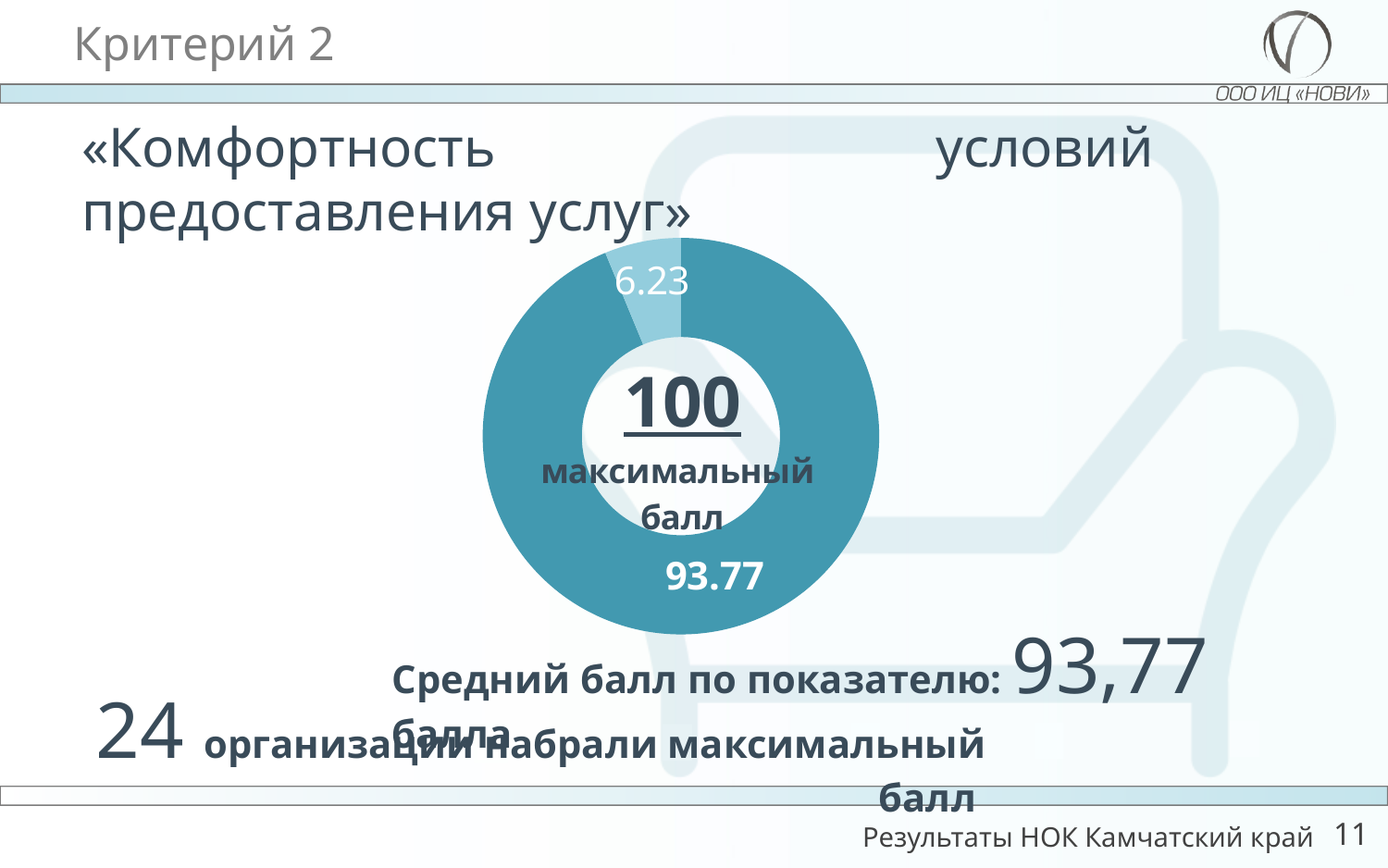
What is the value of the larger slice of the doughnut chart? 93.77 What is the smallest value shown on the doughnut chart? 6.23 What is the largest value shown on the doughnut chart? 93.77 Which slice is larger on the doughnut chart, the one labelled 93.77 or the one labelled 6.23? 93.77 What is the value of the smaller slice of the doughnut chart? 6.23 What text accompanies the number in the centre of the doughnut chart? максимальный балл How many slices does the doughnut chart have? 2 What is the total of the two slice values on the doughnut chart? 100 What kind of chart is shown on the slide? doughnut chart What is the difference between the two slice values on the doughnut chart? 87.54 What number is printed in the centre of the doughnut chart? 100